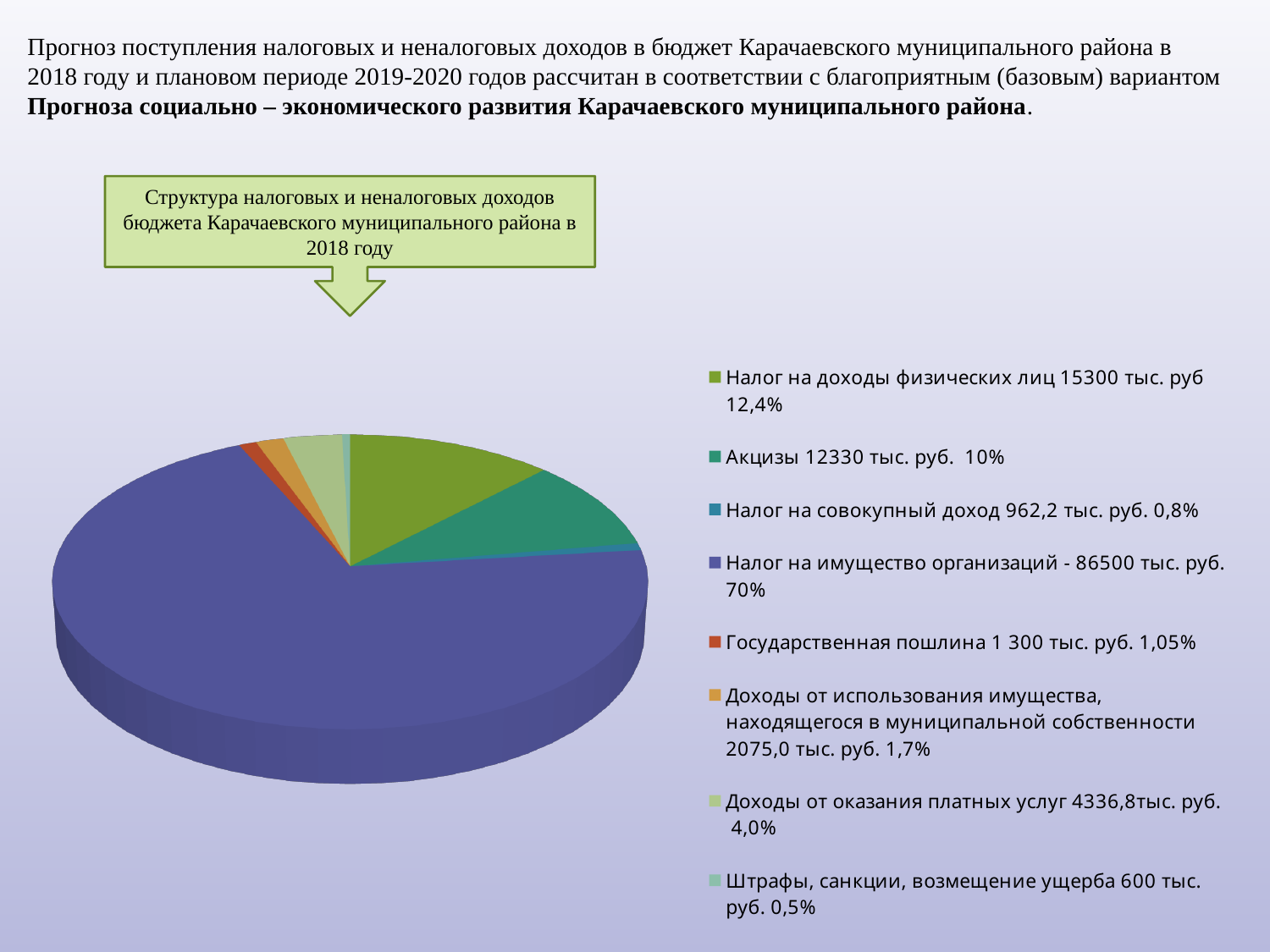
Which category has the smallest share of the pie? Штрафы, санкции, возмещение ущерба Which is larger, the value for Акцизы or the value for Налог на совокупный доход? Акцизы What kind of chart is shown on the slide? Pie chart How many categories does the pie chart's legend list? 8 What is the difference between the values for Налог на доходы физических лиц and Акцизы? 2970 тыс. руб. Which category has the largest share of the pie? Налог на имущество организаций What is the value for Государственная пошлина? 1 300 тыс. руб. What percentage share is shown for Доходы от оказания платных услуг? 4,0% What is the value for Налог на доходы физических лиц? 15300 тыс. руб What share of the pie does Налог на имущество организаций account for? 70% What is the value for Акцизы? 12330 тыс. руб. What is the title shown in the box above the pie chart? Структура налоговых и неналоговых доходов бюджета Карачаевского муниципального района в 2018 году